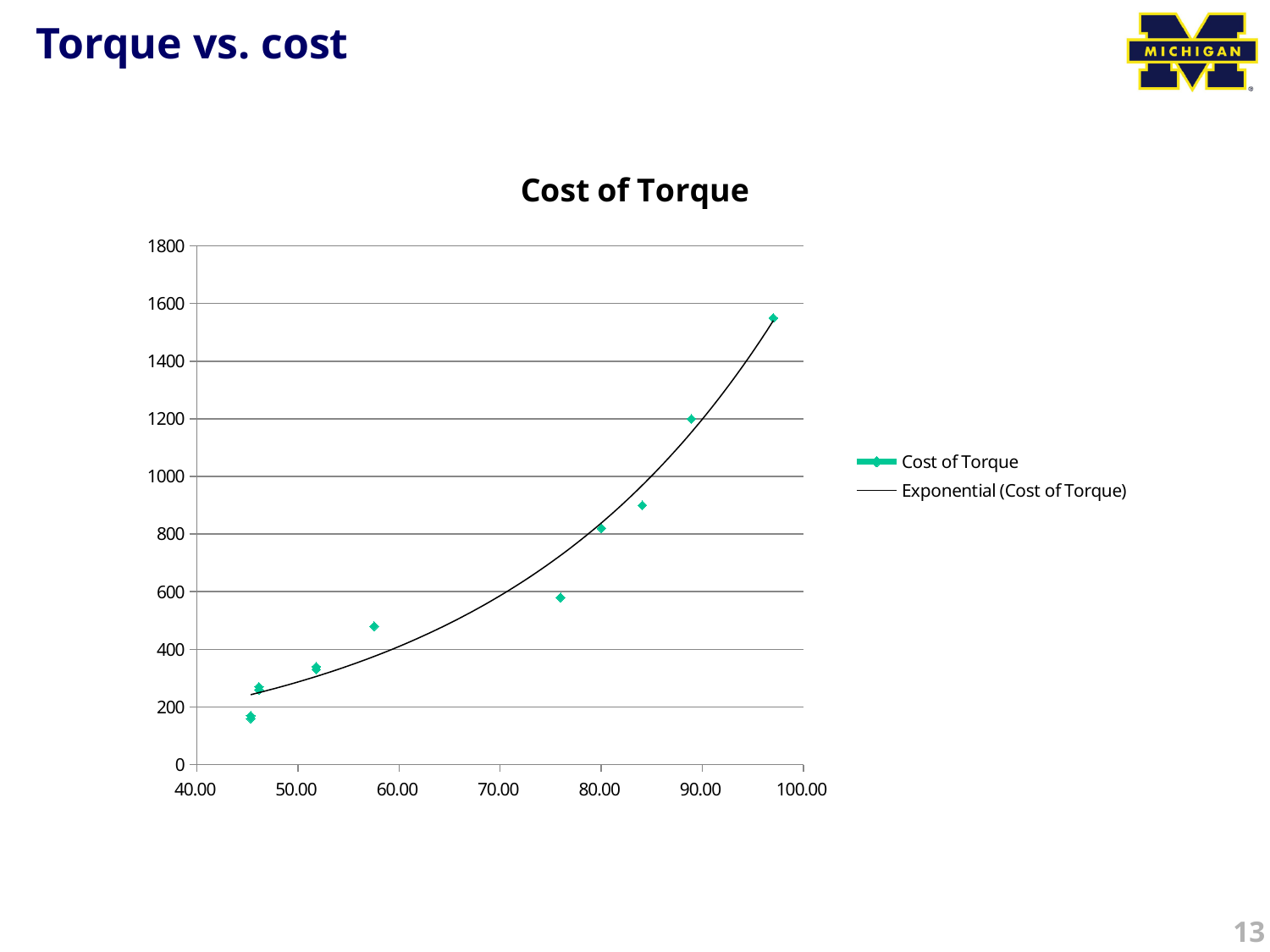
What is the title of the chart? Cost of Torque How many entries does the chart legend list? 2 What is the highest value shown on the y axis? 1800 Is the lowest plotted Cost of Torque value greater or less than 200? less What is the name of the trendline entry in the legend? Exponential (Cost of Torque) Is the Cost of Torque value for the point near 76 on the x axis greater or less than 800? less Is the Cost of Torque value for the point near 89 on the x axis greater or less than 1000? greater Do the Cost of Torque values rise or fall as torque increases along the x axis? Rise What kind of chart is shown on the slide? Scatter chart